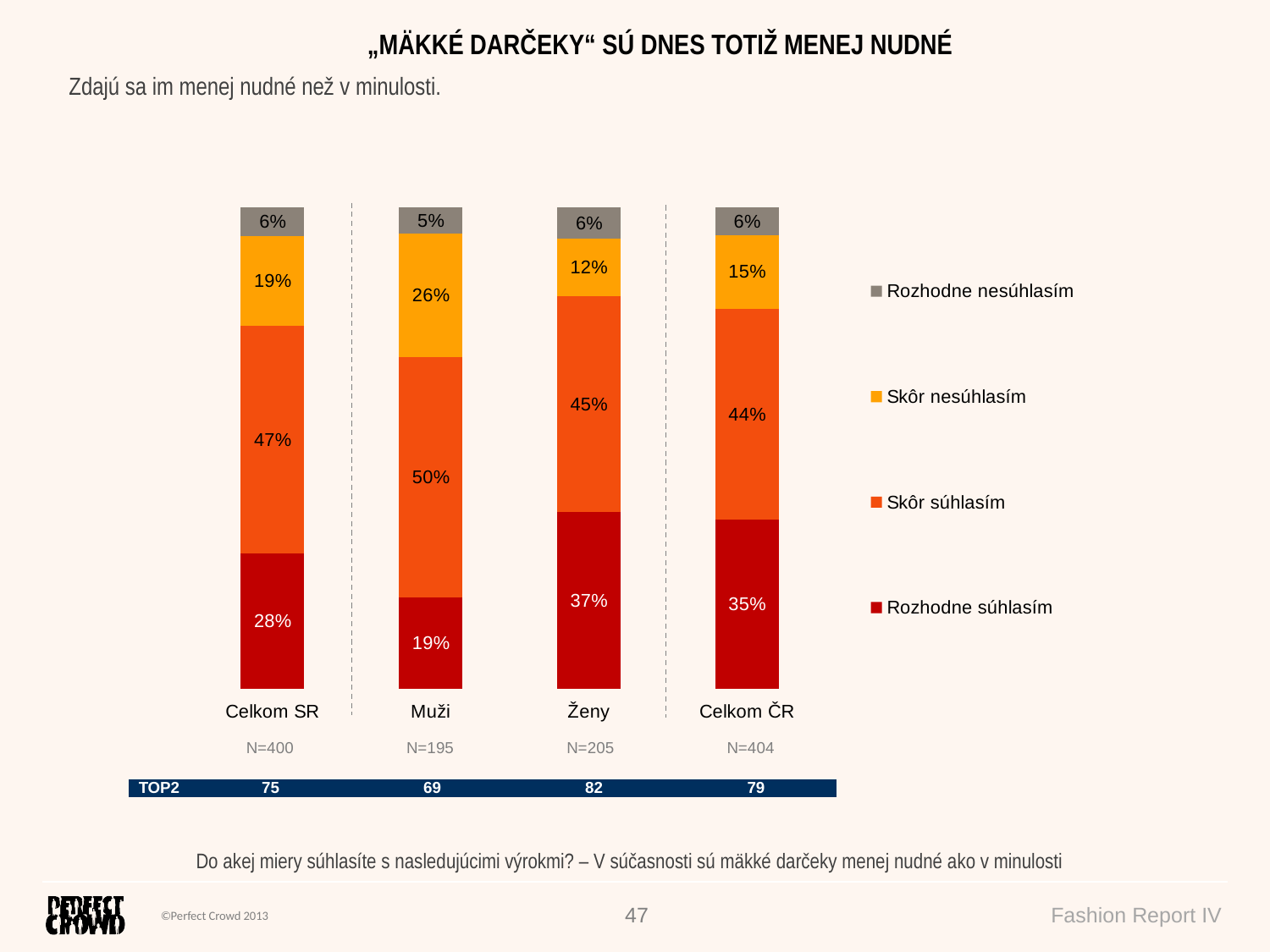
How many series does the legend list? 4 How many categories are shown on the x axis? 4 What kind of chart is shown on the slide? Stacked bar chart Which is larger: the "Rozhodne súhlasím" value for Celkom SR or for Muži? Celkom SR Which category has the highest value for "Rozhodne súhlasím"? Ženy Which category has the lowest value for "Skôr nesúhlasím"? Ženy What is the value of "Rozhodne súhlasím" for Ženy? 37% What is the value of "Skôr nesúhlasím" for Celkom ČR? 15% What is the difference between the "Skôr nesúhlasím" values for Muži and Ženy? 14% What is the value of "Skôr súhlasím" for Muži? 50% What is the value of "Rozhodne nesúhlasím" for Celkom SR? 6% What is the TOP2 value shown for Ženy? 82